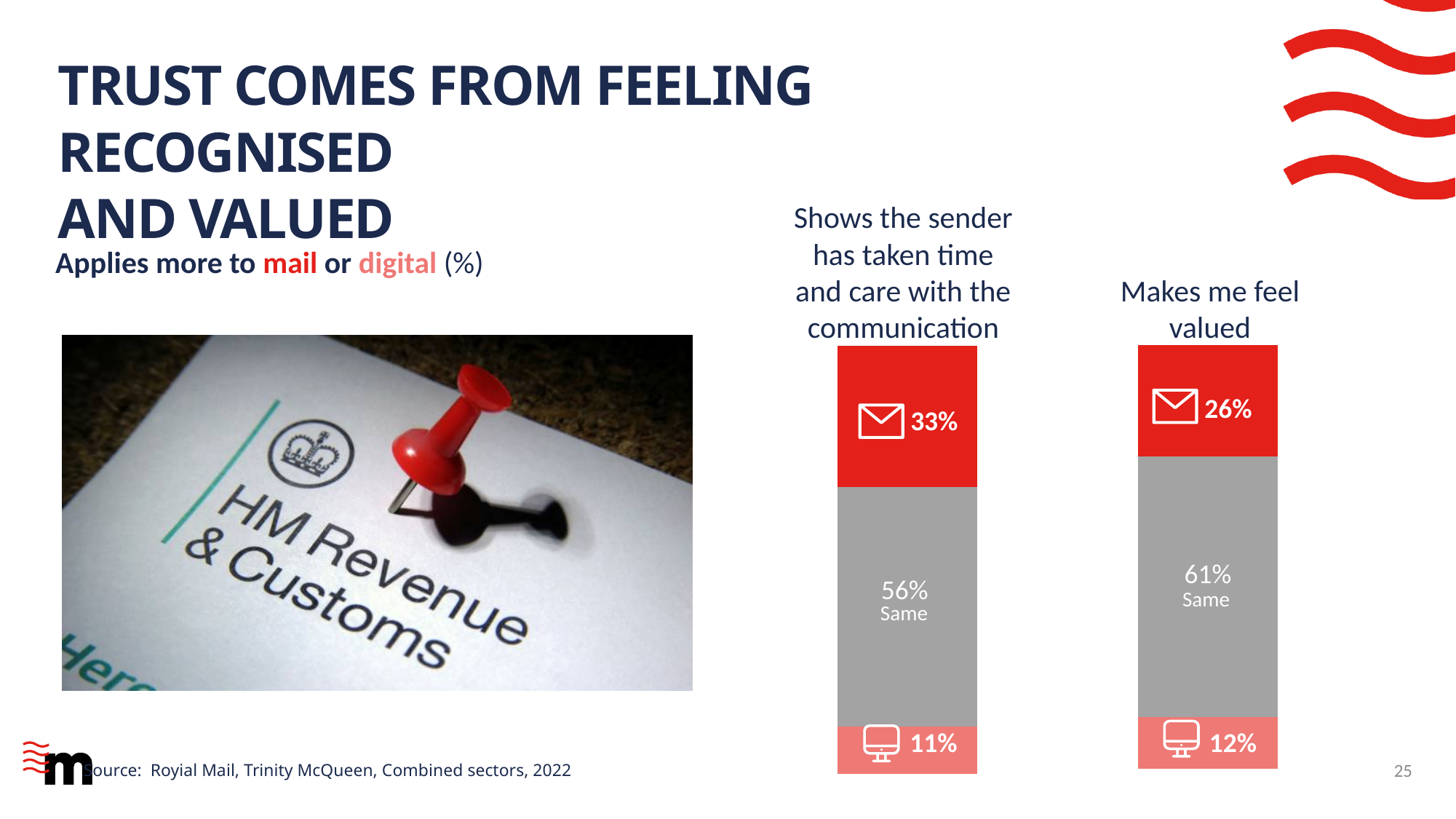
What colour represents mail in the chart? Red What percentage say 'Shows the sender has taken time and care with the communication' applies more to mail? 33% How many statements (bars) are shown in the chart? 2 What is the difference between the mail and digital percentages for 'Makes me feel valued'? 14 percentage points What type of chart is shown on the slide? Stacked bar chart Which statement has the higher mail percentage? Shows the sender has taken time and care with the communication What percentage say 'Makes me feel valued' applies more to digital? 12% What is the difference between the mail and digital percentages for 'Shows the sender has taken time and care with the communication'? 22 percentage points What is the 'Same' value for 'Makes me feel valued'? 61% For 'Makes me feel valued', is the mail percentage or the digital percentage larger? Mail What is the 'Same' value for 'Shows the sender has taken time and care with the communication'? 56% What percentage say 'Makes me feel valued' applies more to mail? 26%